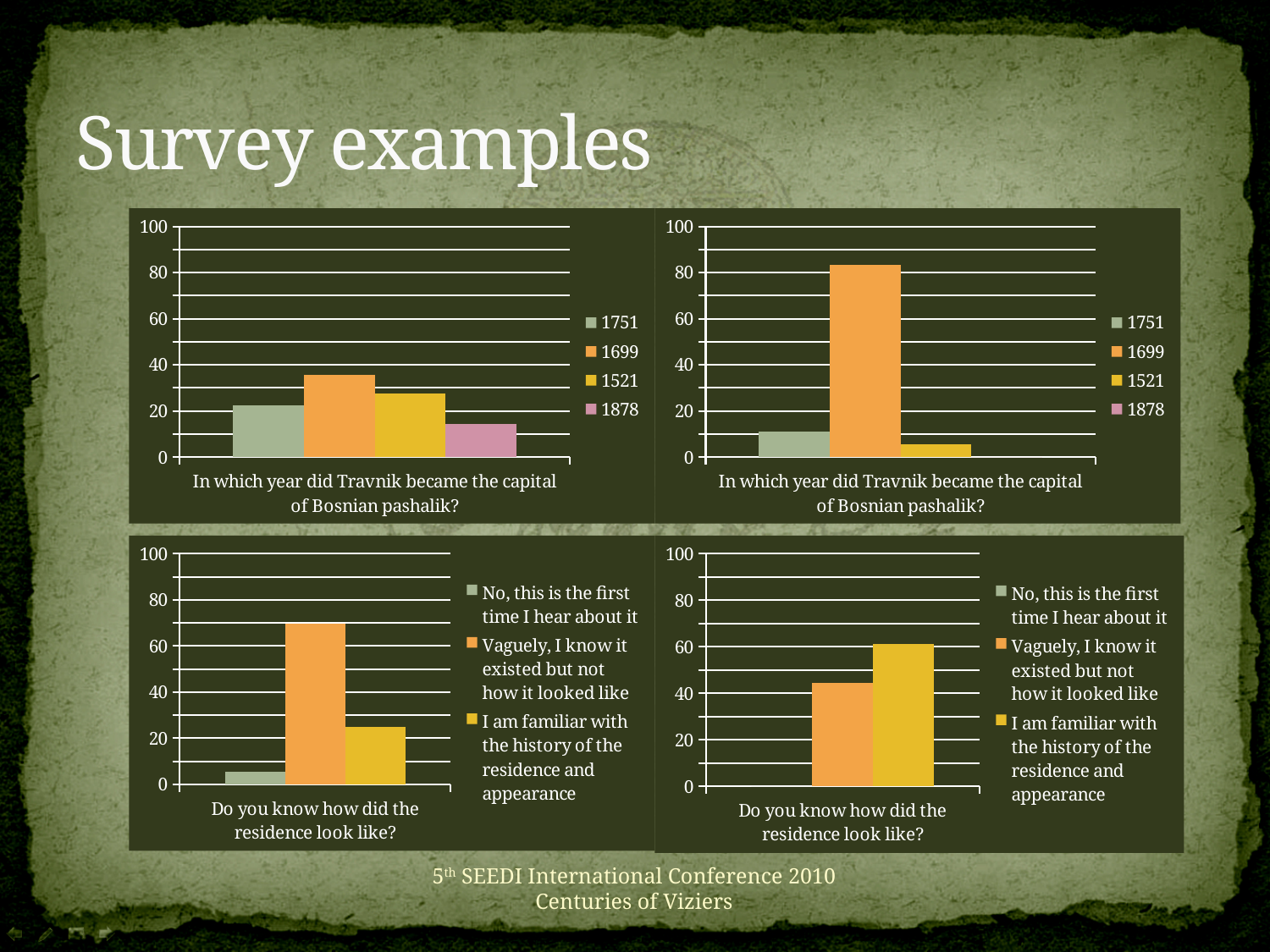
In the top-left chart, is the value for 1699 greater or less than 20? greater In the bottom-left chart, which response has the tallest bar? Vaguely, I know it existed but not how it looked like In the top-right chart, is the value for 1751 greater or less than 20? less In the top-left chart, which year has the shortest bar? 1878 In the bottom-left chart, is the value for 'Vaguely, I know it existed but not how it looked like' greater or less than 60? greater In the top-right chart, which year has the tallest bar? 1699 In the top-left chart, which year has the tallest bar? 1699 How many series does the legend of the top-right chart list? 4 What kind of chart is the bottom-right chart? bar chart In the bottom-right chart, which is larger: 'Vaguely, I know it existed but not how it looked like' or 'I am familiar with the history of the residence and appearance'? I am familiar with the history of the residence and appearance